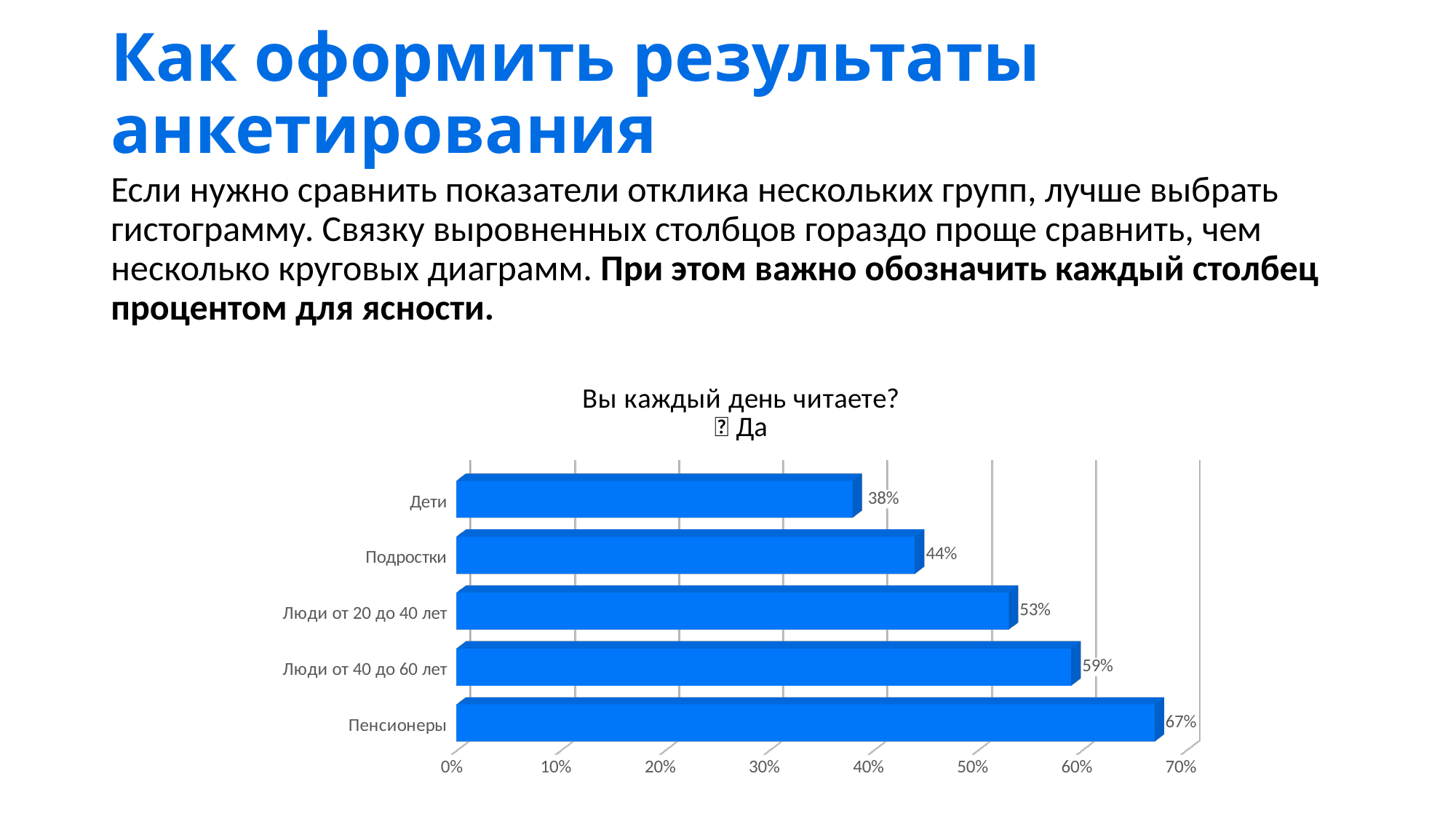
What kind of chart is shown on the slide? bar chart What is the value for Люди от 20 до 40 лет? 53% What is the title of the chart? Вы каждый день читаете? Да What is the value for Пенсионеры? 67% Which category has the lowest value? Дети Is the value for Люди от 40 до 60 лет greater or less than 50%? greater What is the value for Дети? 38% Which is larger, the value for Подростки or the value for Люди от 20 до 40 лет? Люди от 20 до 40 лет What is the difference between the values for Пенсионеры and Дети? 29% How many categories are shown in the chart? 5 Which category has the highest value? Пенсионеры What is the difference between the values for Люди от 40 до 60 лет and Подростки? 15%